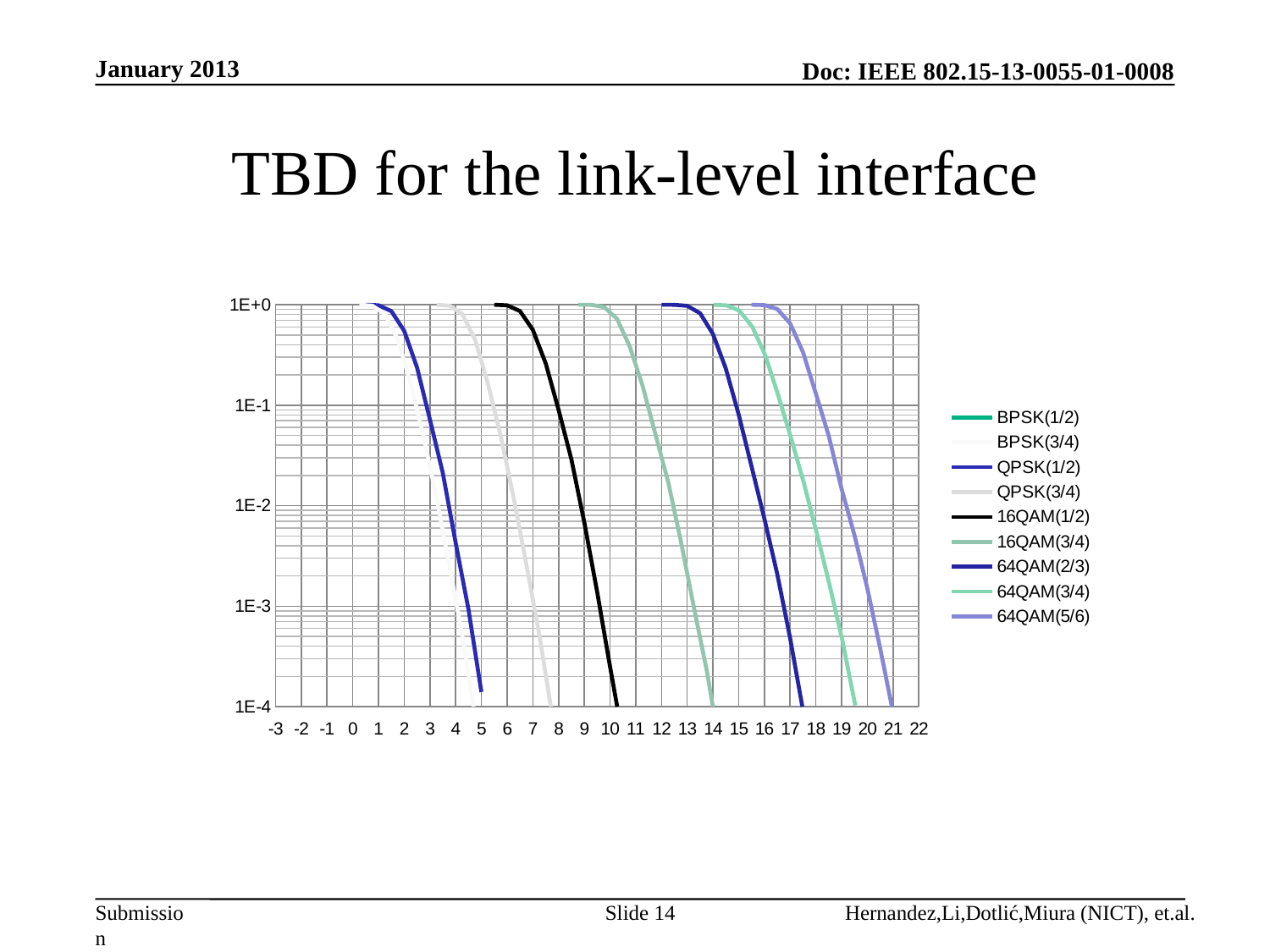
Which series is plotted in black? 16QAM(1/2) Is the value for 16QAM(1/2) at x = 10 greater or less than 1E-3? less What is the title of the slide containing the chart? TBD for the link-level interface Is the value for 64QAM(2/3) at x = 16 greater or less than 1E-1? less Which of the two series, 16QAM(1/2) or 64QAM(5/6), reaches 1E-4 at a larger x-axis value? 64QAM(5/6) What kind of chart is shown on the slide? line chart How many series does the chart's legend list? 9 Which series reaches 1E-4 at the highest x-axis value? 64QAM(5/6) Is the value for 64QAM(5/6) at x = 17 greater or less than 1E-1? greater Do the plotted curves rise or fall as the x-axis value increases? fall